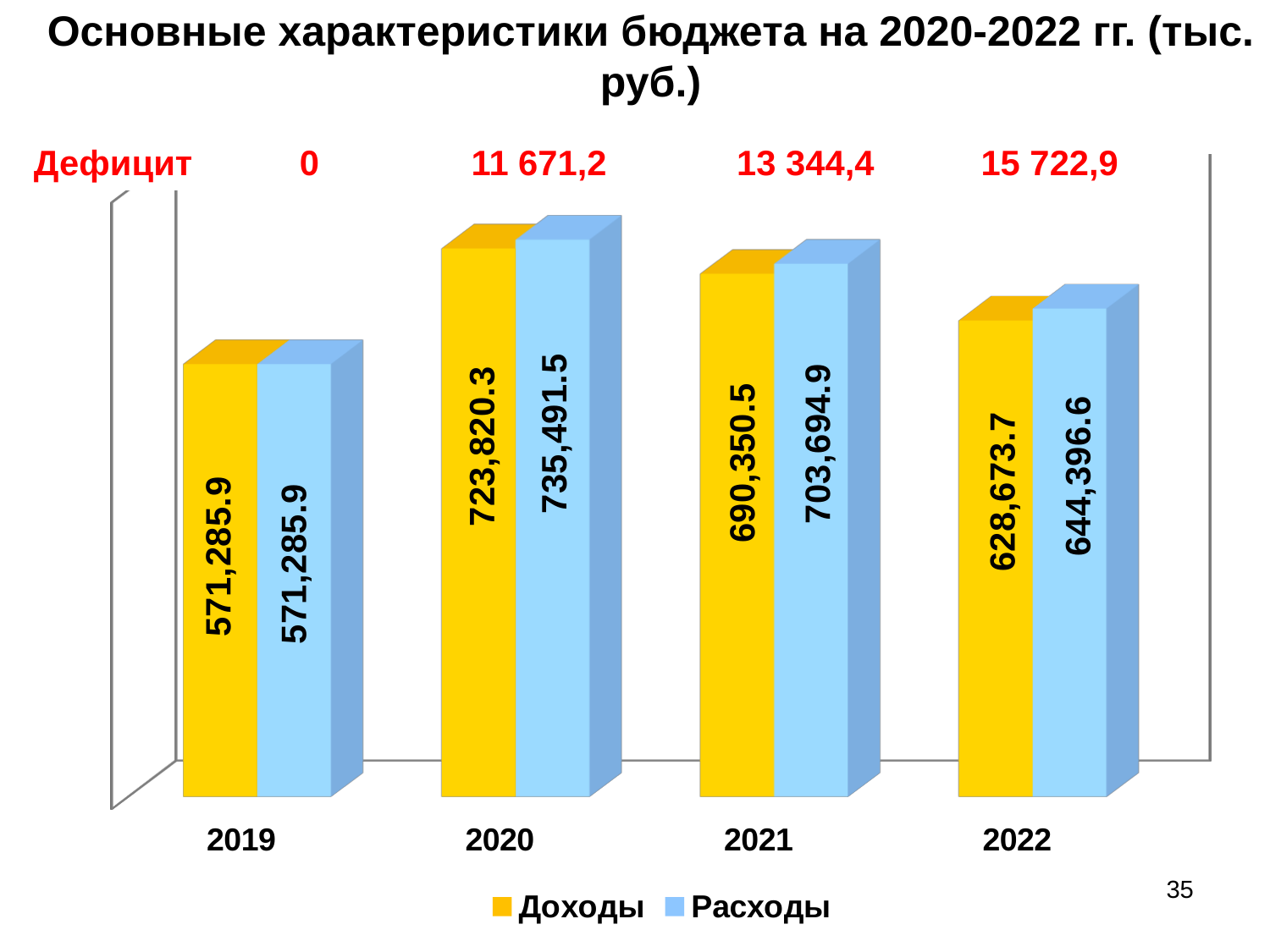
Do the Доходы values rise or fall from 2020 to 2022? Fall What is the value of Расходы for 2022? 644,396.6 What is the difference between Расходы and Доходы in 2022? 15,722.9 How many years are shown on the x axis? 4 What is the value of Доходы for 2019? 571,285.9 What kind of chart is shown on the slide? Bar chart What is the value of Расходы for 2021? 703,694.9 In which year is Доходы the highest? 2020 Which is larger in 2021, Доходы or Расходы? Расходы What is the value of Доходы for 2020? 723,820.3 In which year is Расходы the lowest? 2019 How many series does the legend list? 2